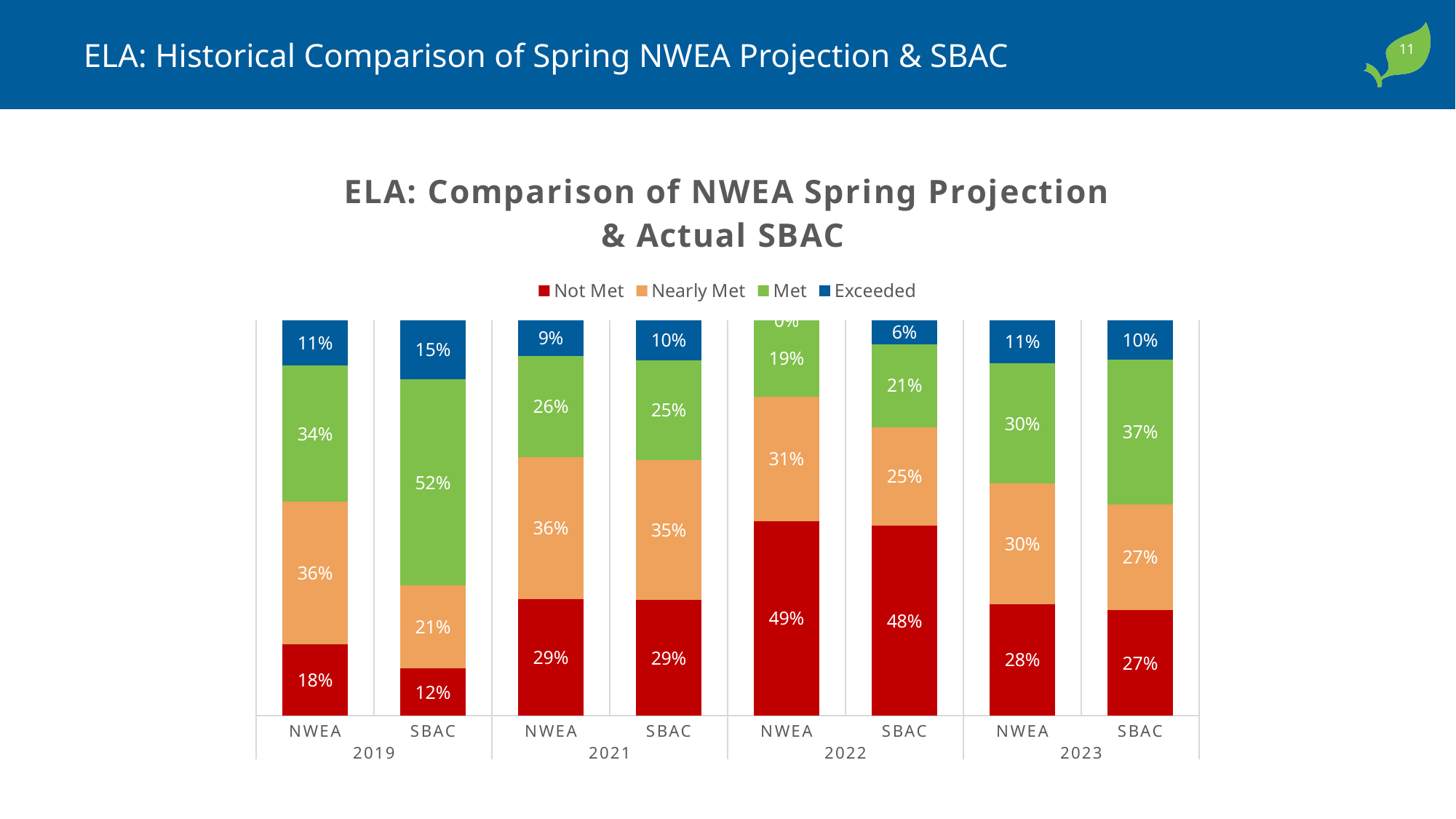
Which series is shown in red in the legend? Not Met What is the Nearly Met percentage for NWEA in 2022? 31% What is the Not Met percentage for SBAC in 2019? 12% How many bars are plotted in the chart? 8 How many series does the legend list? 4 Which is larger, the Nearly Met percentage for NWEA 2021 or for SBAC 2021? NWEA 2021 What is the Exceeded percentage for SBAC in 2022? 6% Which bar has the highest Not Met percentage? NWEA 2022 What is the Met percentage for SBAC in 2023? 37% What kind of chart is shown on the slide? Stacked bar chart Which bar has the lowest Not Met percentage? SBAC 2019 What is the difference between the Met percentage for SBAC 2019 and NWEA 2019? 18%